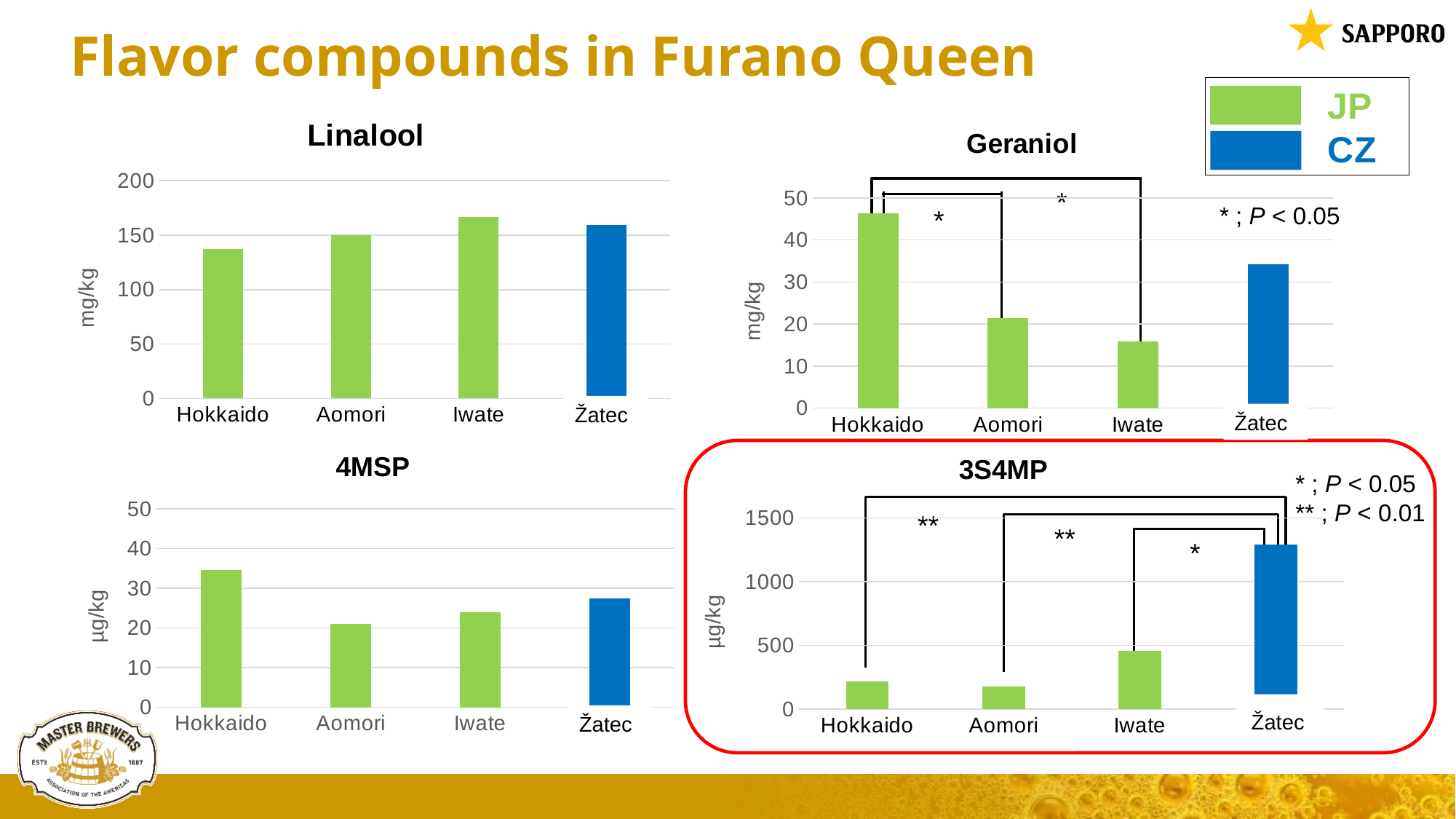
In the 4MSP chart, is the value for Žatec greater or less than 30? less How many categories are shown on the x axis of the Geraniol chart? 4 In the Linalool chart, which category has the lowest value? Hokkaido How many series does the legend in the top right list? 2 In the Geraniol chart, which category has the highest value? Hokkaido In the 4MSP chart, which category has the highest value? Hokkaido In the 3S4MP chart, is the value for Žatec greater or less than 1000? greater In the Geraniol chart, is the value for Žatec greater or less than 30? greater In the 3S4MP chart, which is larger, the value for Iwate or the value for Hokkaido? Iwate In the 3S4MP chart, which category has the highest value? Žatec In the Geraniol chart, which category has the lowest value? Iwate